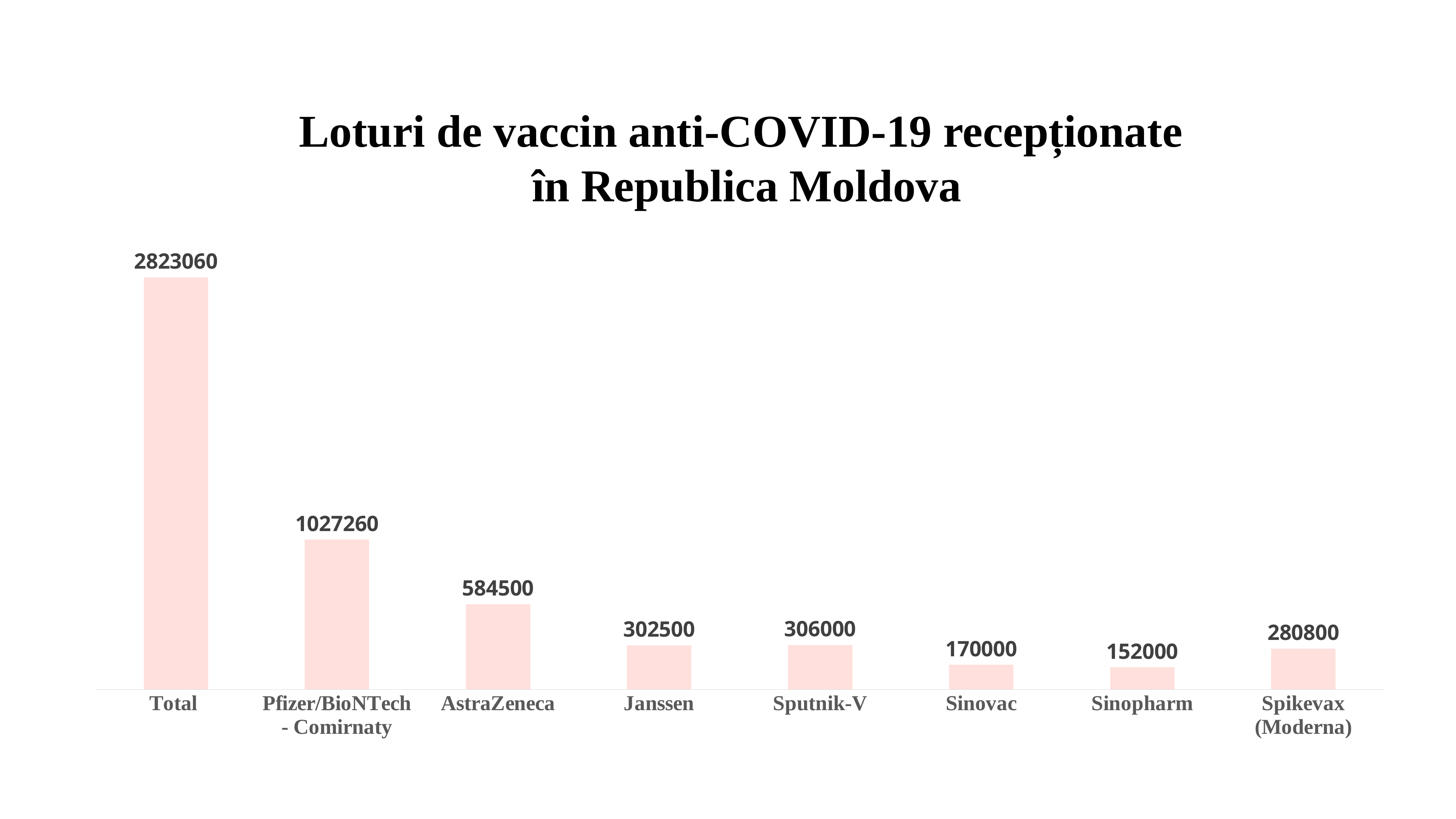
What is the title of the chart? Loturi de vaccin anti-COVID-19 recepționate în Republica Moldova Which category has the lowest value? Sinopharm Excluding Total, which vaccine has the highest value? Pfizer/BioNTech - Comirnaty What is the difference between the values for Sinovac and Sinopharm? 18000 Which is larger, the value for Sputnik-V or the value for Janssen? Sputnik-V How many categories are shown on the x axis? 8 What is the value for Pfizer/BioNTech - Comirnaty? 1027260 What is the value for Spikevax (Moderna)? 280800 What is the value for AstraZeneca? 584500 What kind of chart is shown on the slide? Bar chart What is the value for Total? 2823060 What is the difference between the values for Sputnik-V and Janssen? 3500